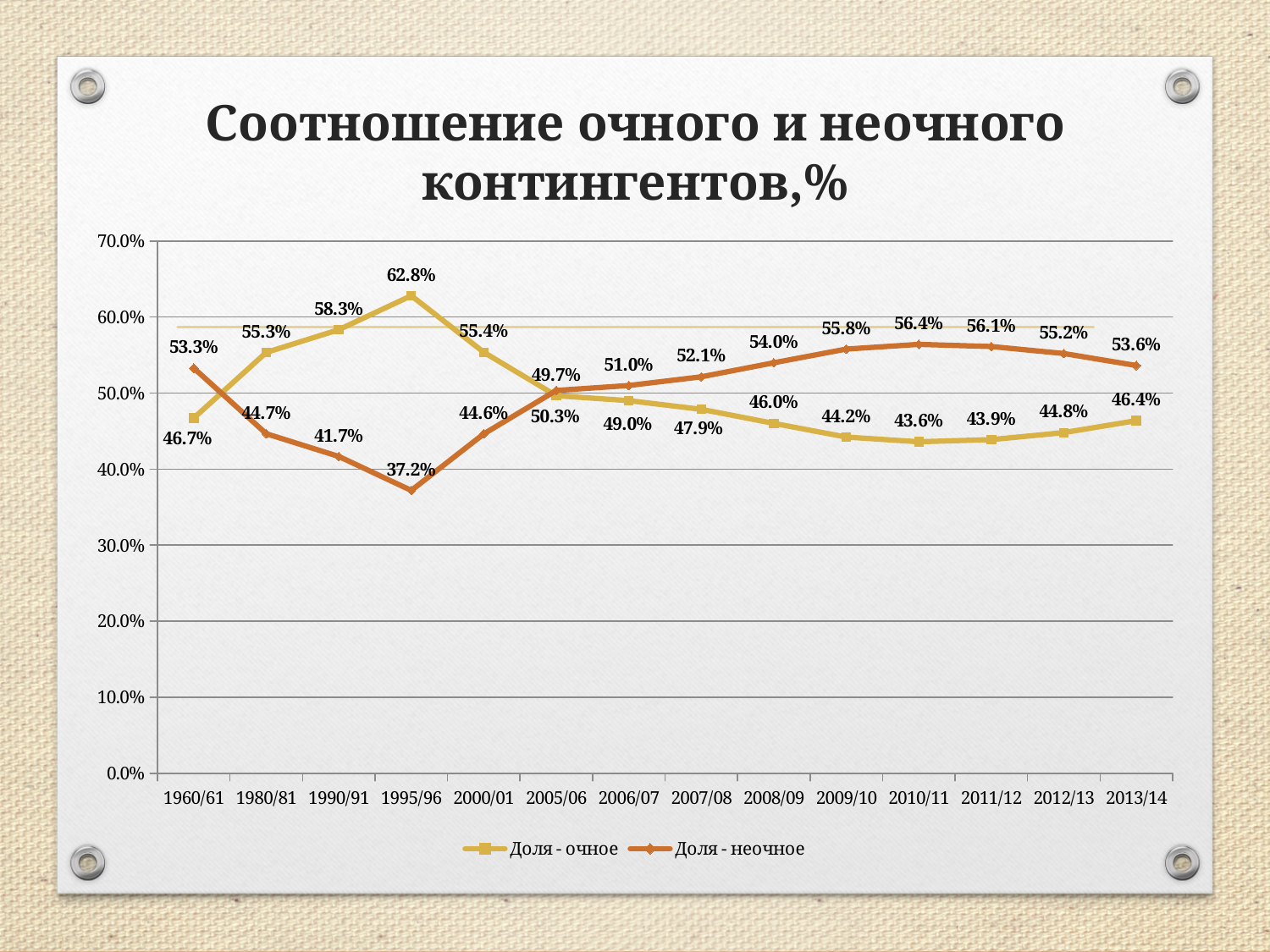
How many academic years are plotted along the x axis? 14 What is the title of the chart? Соотношение очного и неочного контингентов,% What is the difference between "Доля - очное" and "Доля - неочное" in 1995/96? 25.6% How many series does the legend list? 2 What is the value of "Доля - неочное" for 1960/61? 53.3% Which series has the larger value in 2013/14? Доля - неочное What is the value of "Доля - очное" for 1995/96? 62.8% In which year does "Доля - неочное" reach its lowest value? 1995/96 What is the value of "Доля - неочное" for 2010/11? 56.4% What type of chart is shown on the slide? line chart Does "Доля - очное" rise or fall from 2005/06 to 2010/11? fall In which year does "Доля - очное" reach its highest value? 1995/96